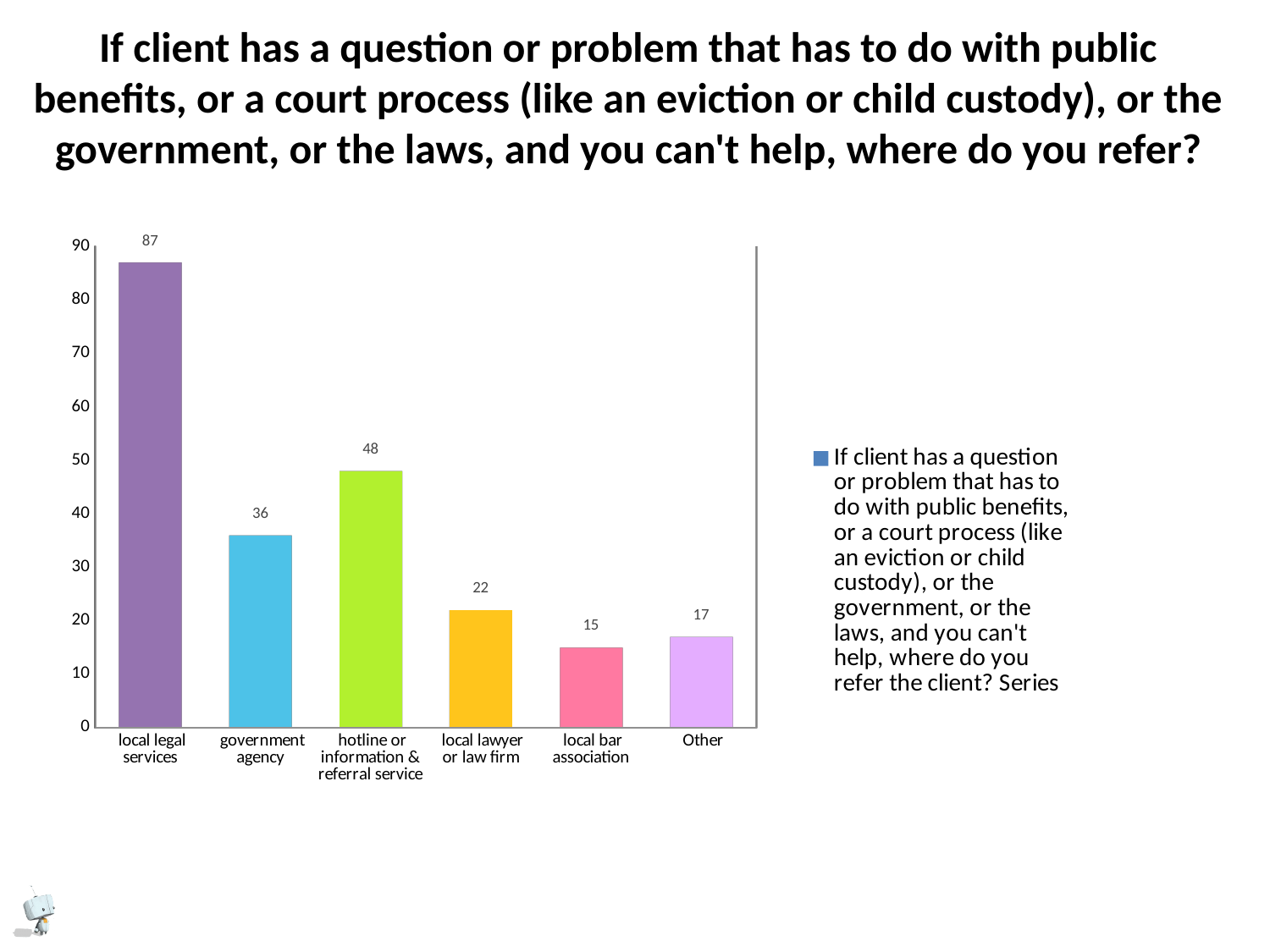
What is the value for Other? 17 What kind of chart is shown on the slide? bar chart What is the value for hotline or information & referral service? 48 What is the difference between the values for hotline or information & referral service and local lawyer or law firm? 26 What is the value for local bar association? 15 How many series does the legend list? 1 Which is larger, the value for government agency or the value for hotline or information & referral service? hotline or information & referral service How many categories are shown on the x axis? 6 Which category has the lowest value? local bar association What is the difference between the values for local legal services and government agency? 51 Which category has the highest value? local legal services What is the value for local legal services? 87